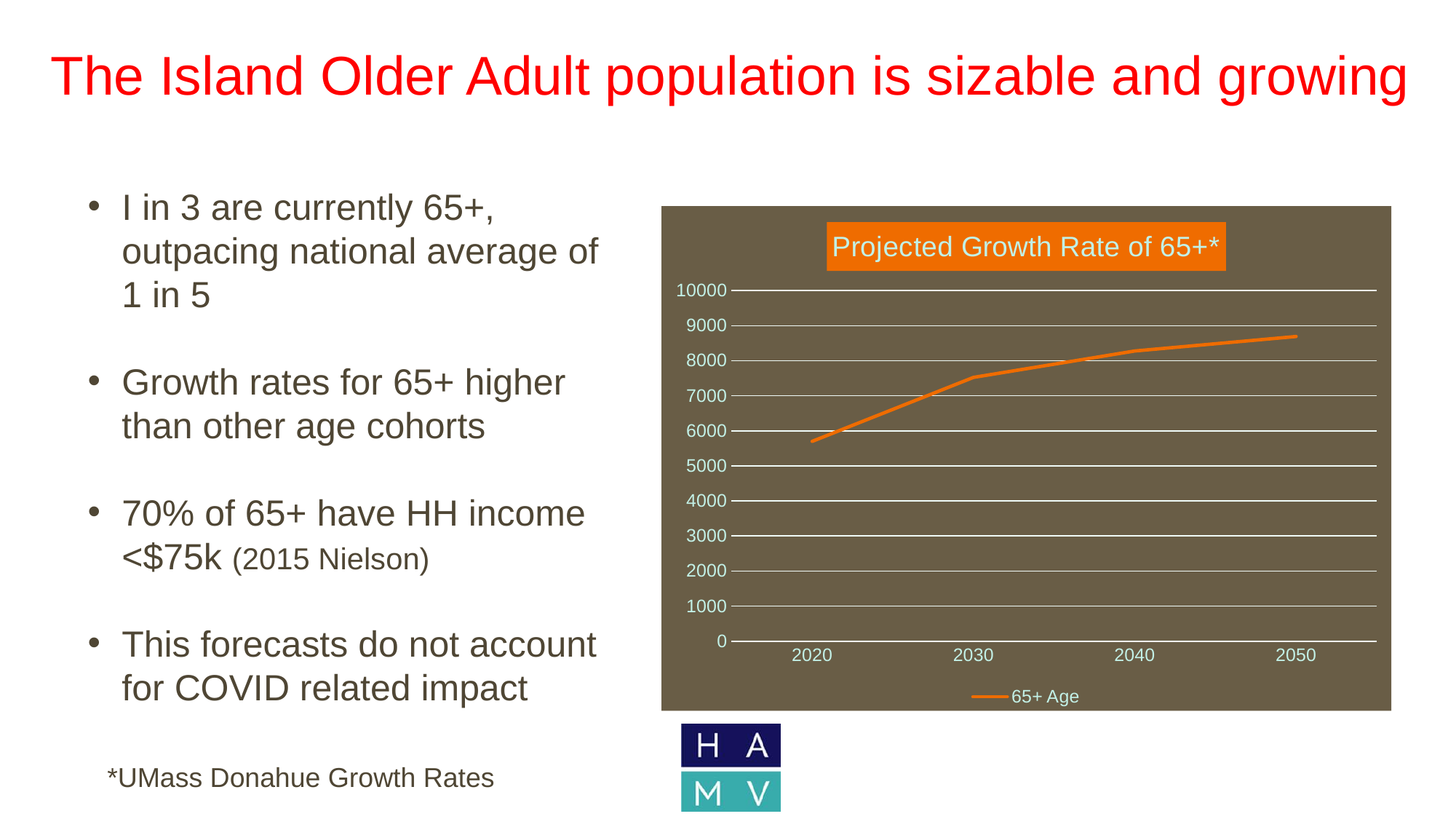
Which year has the lowest value for 65+ Age? 2020 Do the values for 65+ Age rise or fall from 2020 to 2050? rise What is the name of the series shown in the chart legend? 65+ Age Is the value for 2050 greater or less than 9000? less Is the value for 2020 greater or less than 6000? less Which is larger, the value for 2030 or the value for 2020? 2030 Which year has the highest value for 65+ Age? 2050 How many series does the chart legend list? 1 How many years are plotted along the x axis of the chart? 4 What kind of chart is shown on the slide? line chart What is the title of the chart? Projected Growth Rate of 65+* Is the value for 2030 greater or less than 7000? greater